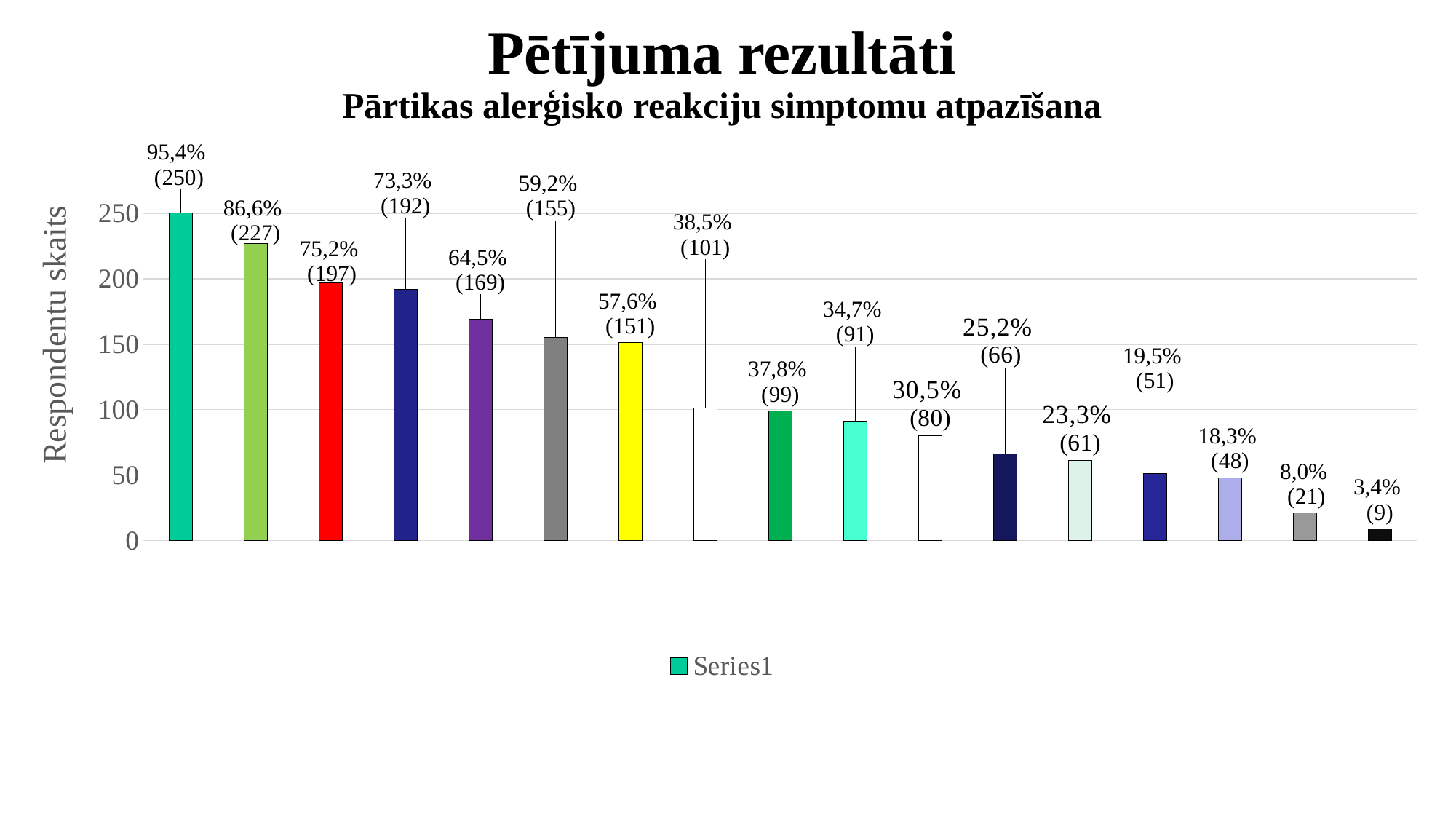
Do the bar values rise or fall from left to right along the x axis? fall What is the value shown above the red bar? 75,2% (197) What is the difference in respondent count between the tallest bar (250) and the shortest bar (9)? 241 What is the value shown above the rightmost (black) bar? 3,4% (9) Which is larger, the red bar or the yellow bar? the red bar Which bar has the highest value? the leftmost bar (250) What is the value shown above the yellow bar? 57,6% (151) What is the value shown above the leftmost (tallest) bar? 95,4% (250) How many bars are plotted in the chart? 17 How many series does the legend list? 1 Which bar has the lowest value? the rightmost black bar (9) What kind of chart is shown on the slide? bar chart